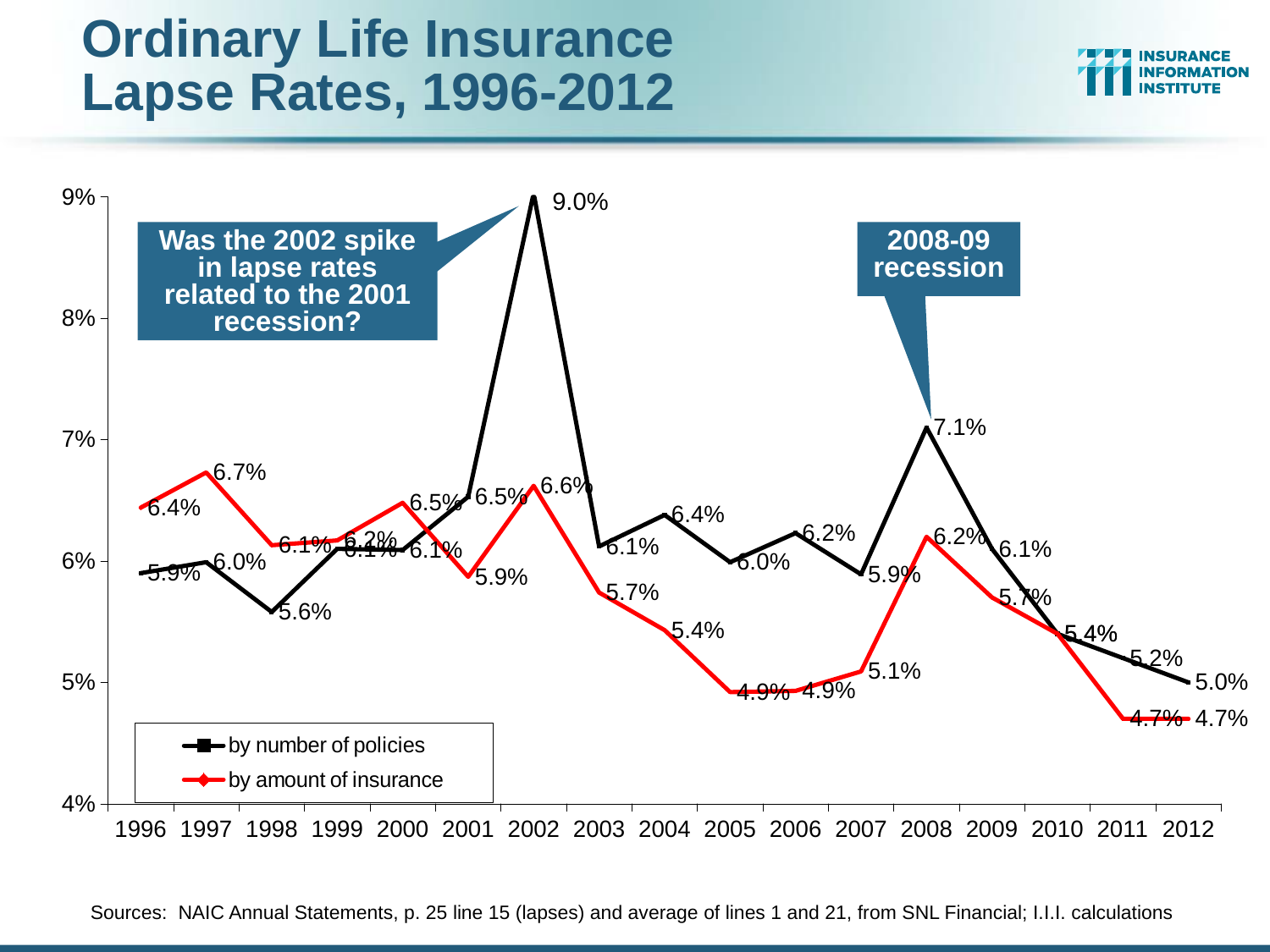
What colour is the line for the 'by amount of insurance' series? red Which series had the higher lapse rate in 2012, by number of policies or by amount of insurance? by number of policies What was the lapse rate by number of policies in 2002? 9.0% What was the lapse rate by amount of insurance in 2012? 4.7% What was the lapse rate by number of policies in 2008? 7.1% What is the difference between the 2002 and 2008 lapse rates by number of policies? 1.9% What type of chart is shown on the slide? line chart How many series does the legend list? 2 In which year was the lapse rate by number of policies highest? 2002 What was the lapse rate by amount of insurance in 1997? 6.7% How many years are plotted along the x axis? 17 Did the lapse rate by number of policies rise or fall from 2008 to 2012? fall